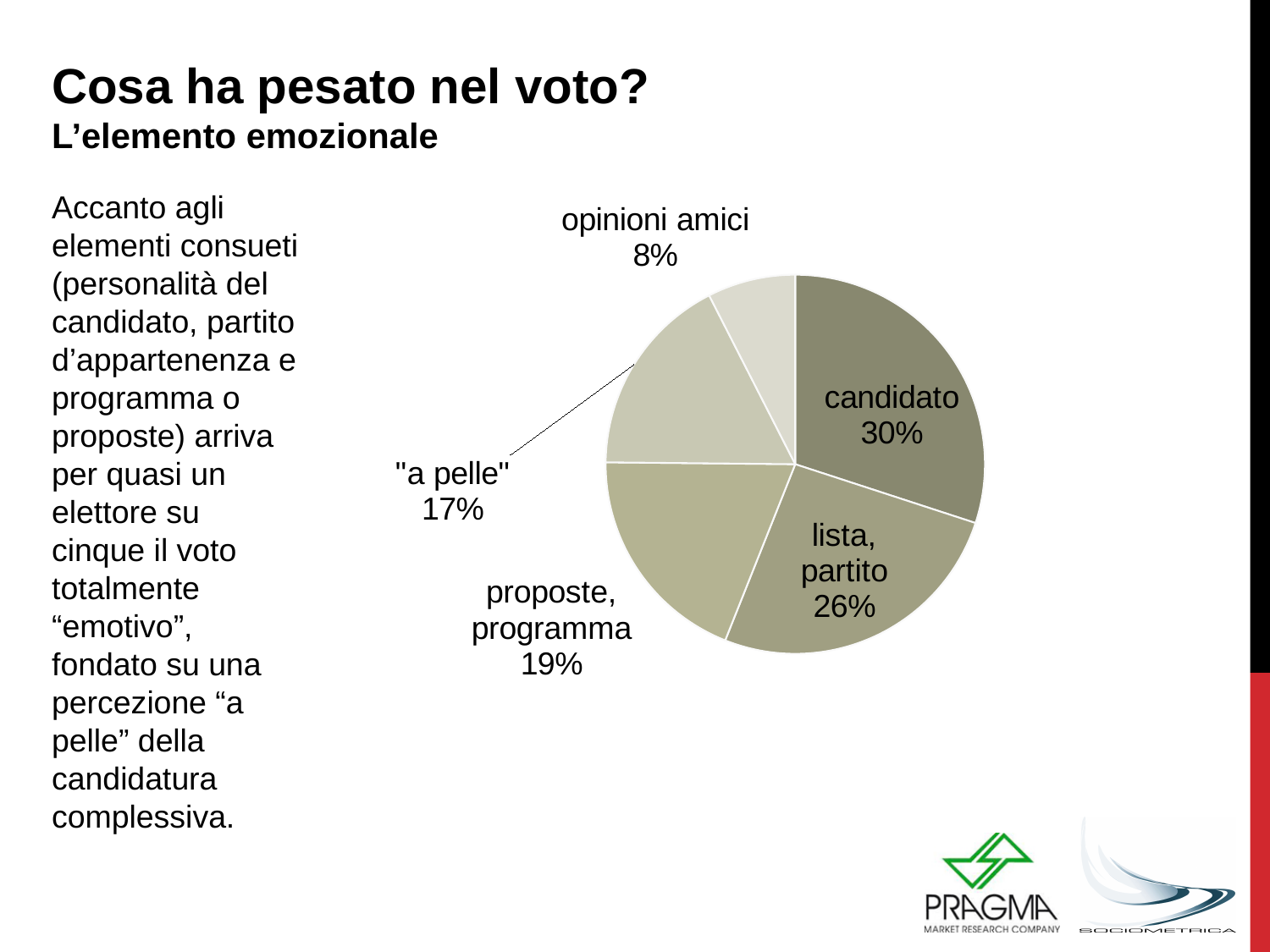
What share of the pie does "proposte, programma" have? 19% What share of the pie does "a pelle" have? 17% What is the difference in percentage points between "candidato" and "lista, partito"? 4 What share of the pie does "lista, partito" have? 26% Which is larger, the share for "proposte, programma" or the share for "a pelle"? proposte, programma Which slice of the pie is the smallest? opinioni amici What share of the pie does "candidato" have? 30% Which slice of the pie is the largest? candidato What kind of chart is shown on the slide? pie chart How many slices does the pie chart have? 5 What is the combined share of "a pelle" and "opinioni amici"? 25% What share of the pie does "opinioni amici" have? 8%